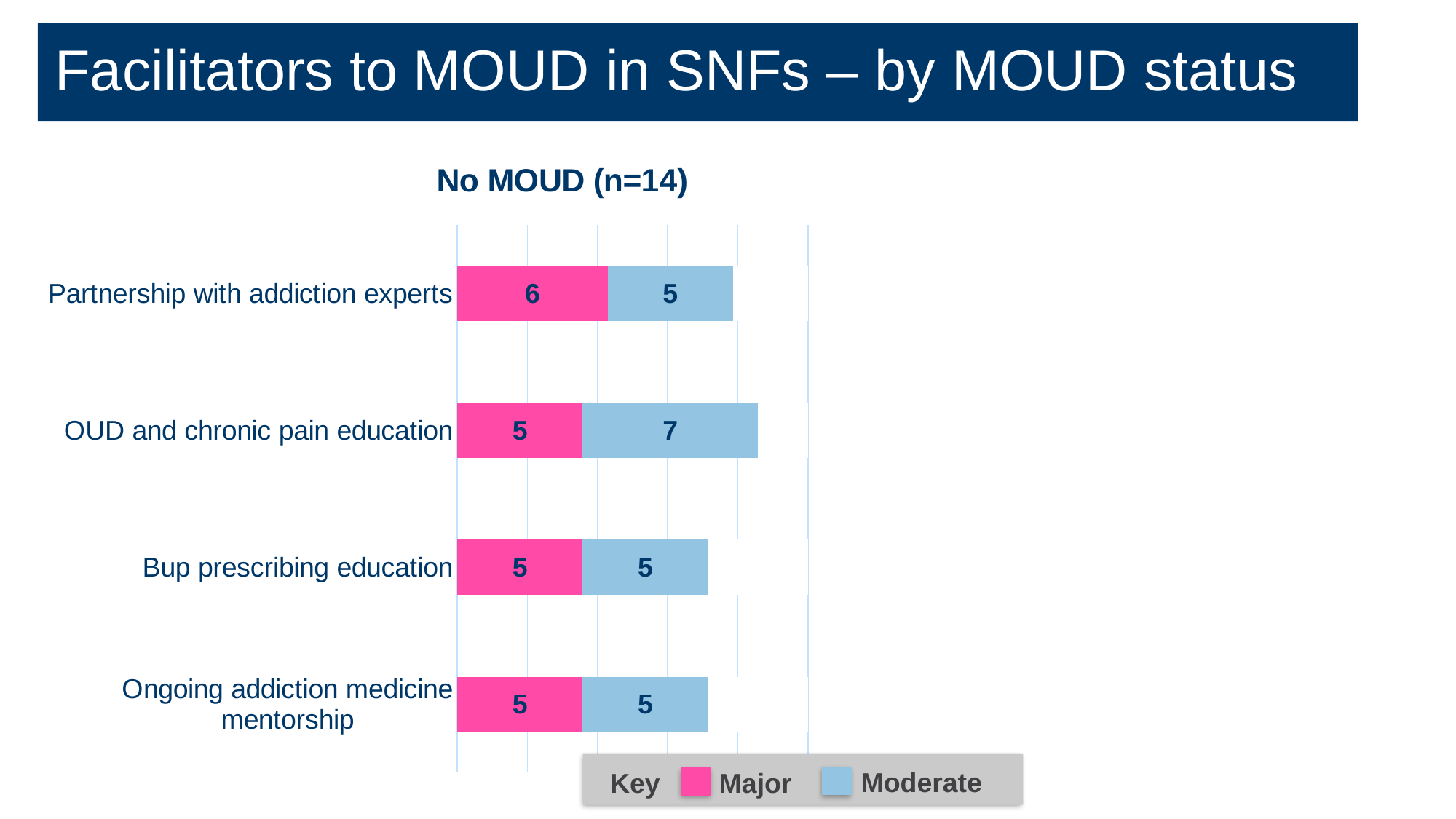
What is the Major value for Bup prescribing education? 5 What is the total of the stacked bar for Partnership with addiction experts? 11 Is the Major value for Partnership with addiction experts larger or smaller than the Major value for Bup prescribing education? larger Which category has the highest Major value? Partnership with addiction experts Which category has the highest Moderate value? OUD and chronic pain education What is the Moderate value for OUD and chronic pain education? 7 What is the difference between the Moderate and Major values for OUD and chronic pain education? 2 What is the Major value for Partnership with addiction experts? 6 How many series does the key list? 2 How many categories are shown in the chart? 4 What is the total of the stacked bar for OUD and chronic pain education? 12 What is the Moderate value for Ongoing addiction medicine mentorship? 5